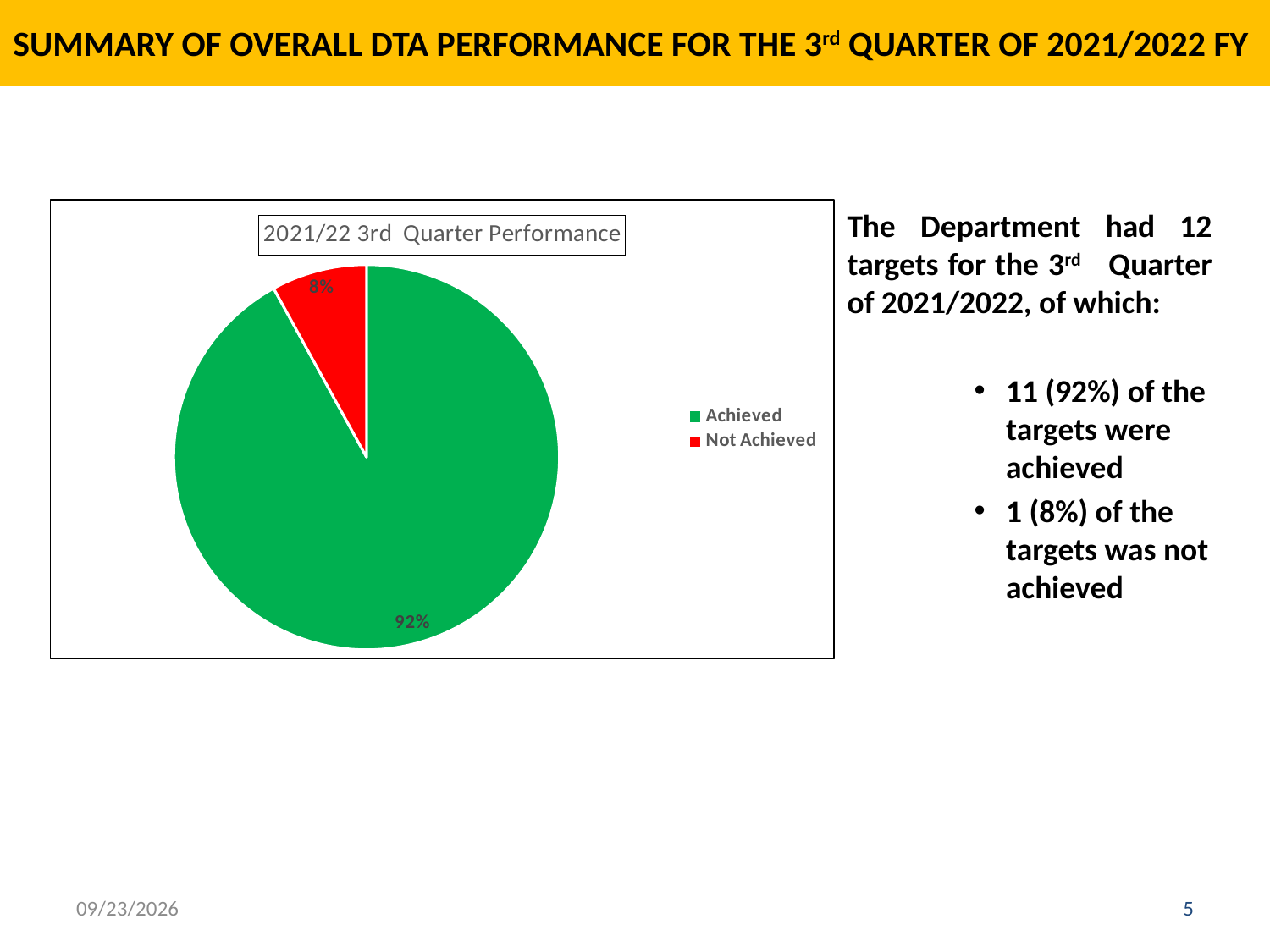
How many entries does the legend list? 2 What is the difference in percentage points between the Achieved and Not Achieved slices? 84 Which is larger, the Achieved slice or the Not Achieved slice? Achieved Which slice of the pie is the largest? Achieved Which slice of the pie is the smallest? Not Achieved What colour is the Not Achieved slice? Red What share of the pie is labelled Achieved? 92% How many slices does the pie chart have? 2 What kind of chart is shown on the slide? Pie chart What is the title of the chart? 2021/22 3rd Quarter Performance What share of the pie is labelled Not Achieved? 8%